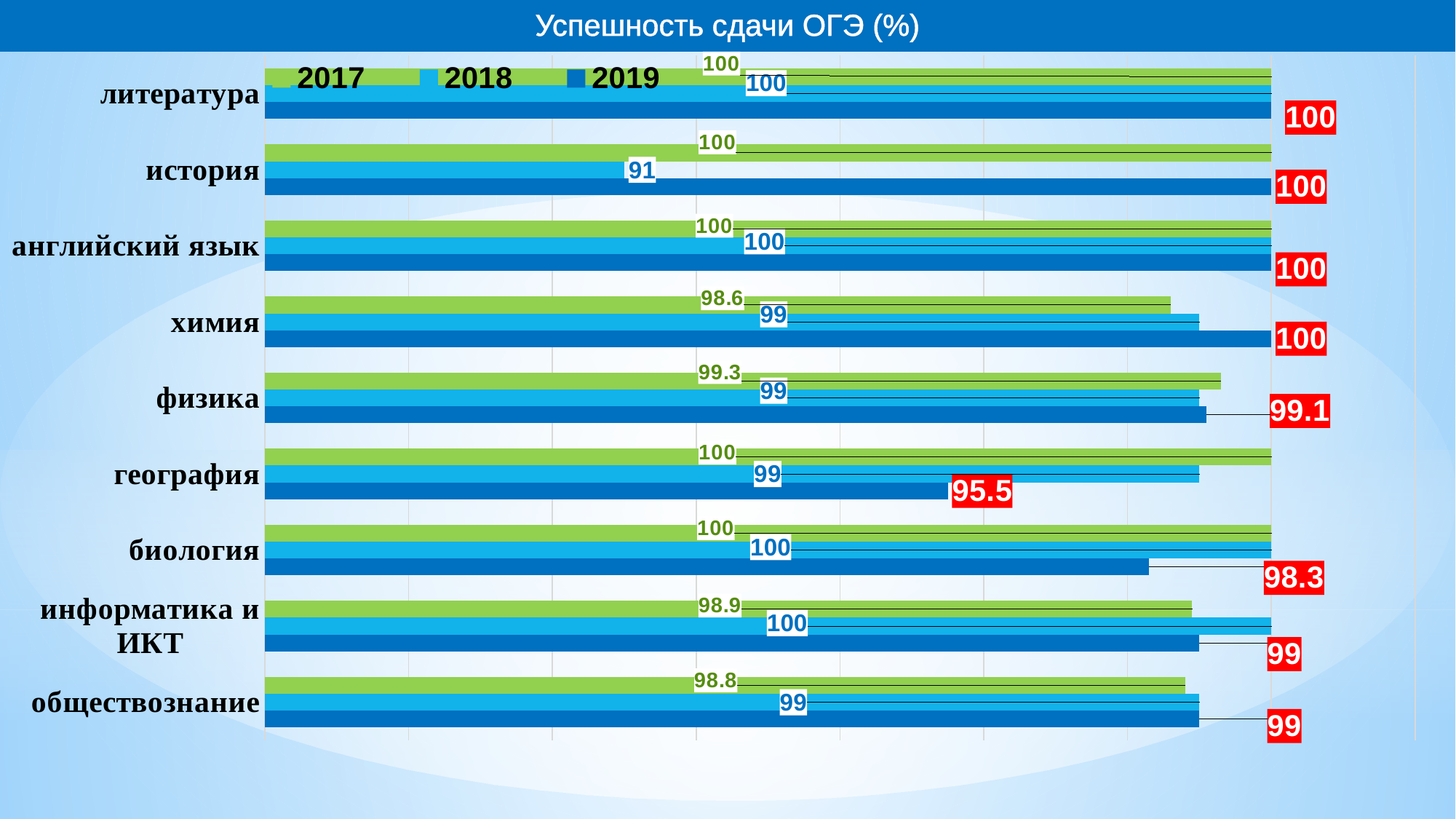
What is the title of the chart? Успешность сдачи ОГЭ (%) Which subject has the lowest 2018 value? история What is the 2017 value for химия? 98.6 How many subjects (categories) are shown on the chart? 9 Which subject has the lowest 2019 value? география What is the difference between the 2017 and 2019 values for география? 4.5 What is the 2019 value for география? 95.5 What type of chart is shown on the slide? bar chart How many series does the legend list? 3 What is the 2018 value for история? 91 What is the 2019 value for биология? 98.3 For физика, which is larger: the 2017 value or the 2019 value? 2017